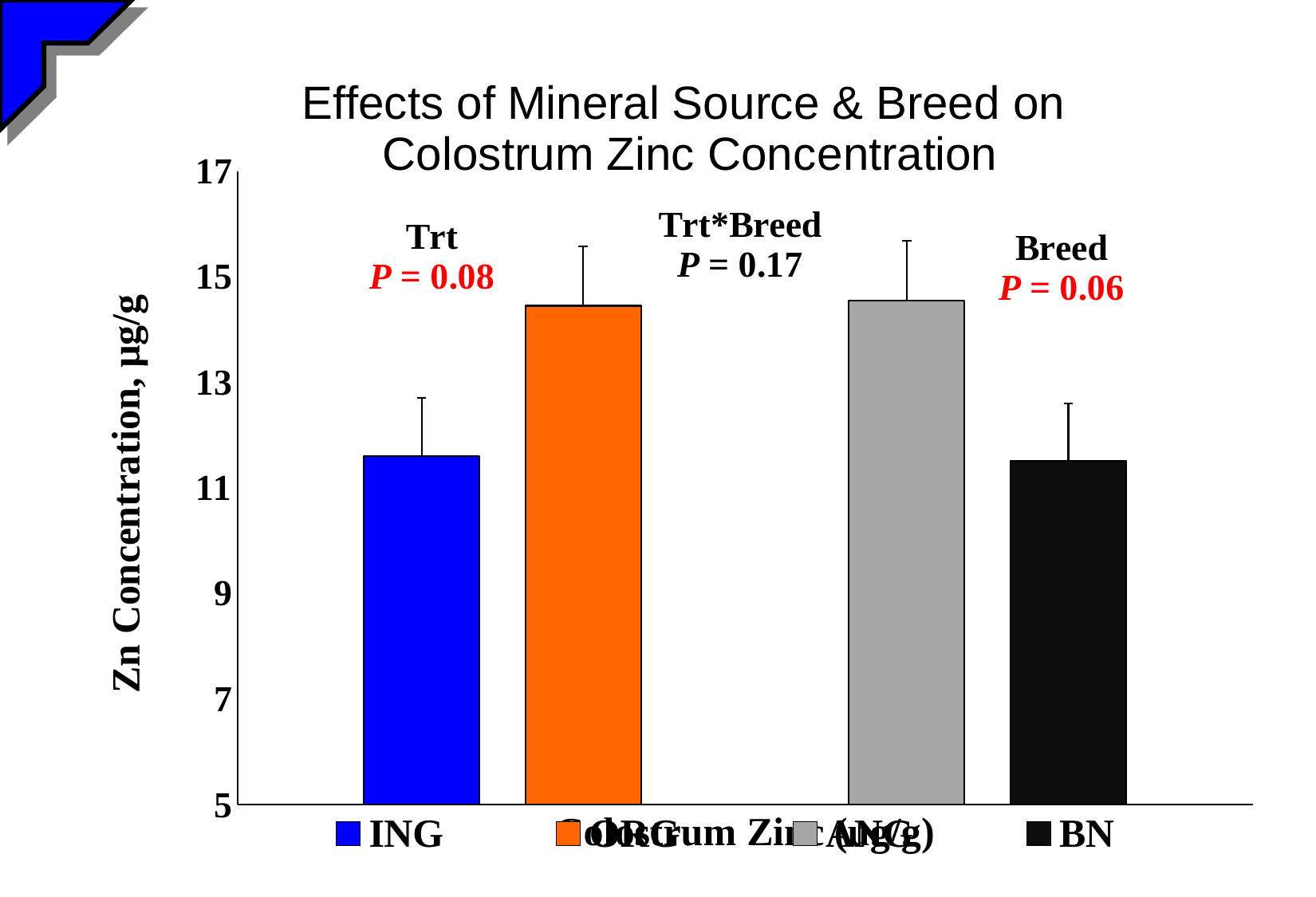
Is the value for the gray bar greater or less than 13? greater Is the value for ING greater or less than 13? less Which is larger, the value for ING or the value for ORG? ORG Is the value for ORG greater or less than 13? greater What is the title of the chart? Effects of Mineral Source & Breed on Colostrum Zinc Concentration What P value is shown for the Breed effect on the chart? P = 0.06 What kind of chart is shown on the slide? bar chart How many entries does the legend list? 4 How many bars are plotted in the chart? 4